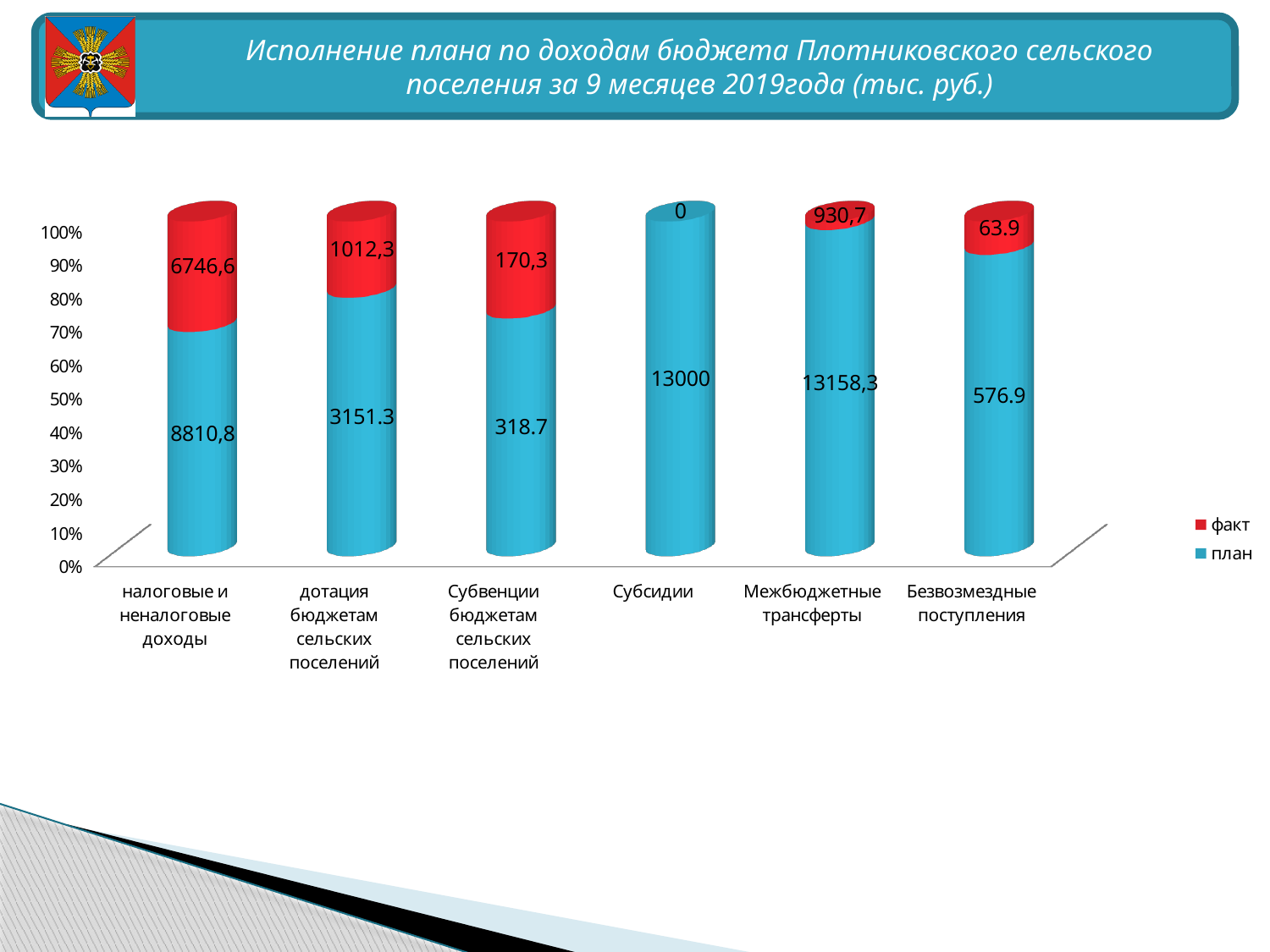
How many categories are shown on the x axis? 6 Which category has the lowest факт value? Субсидии Which is larger, the факт value for налоговые и неналоговые доходы or the факт value for Межбюджетные трансферты? налоговые и неналоговые доходы Which category has the highest план value? Межбюджетные трансферты What is the план value for налоговые и неналоговые доходы? 8810,8 What is the факт value for Субсидии? 0 What is the план value for Межбюджетные трансферты? 13158,3 How many series does the legend list? 2 What kind of chart is shown on the slide? Stacked bar chart What is the difference between the план and факт values for Субвенции бюджетам сельских поселений? 148.4 What is the факт value for Безвозмездные поступления? 63.9 What is the факт value for дотация бюджетам сельских поселений? 1012,3